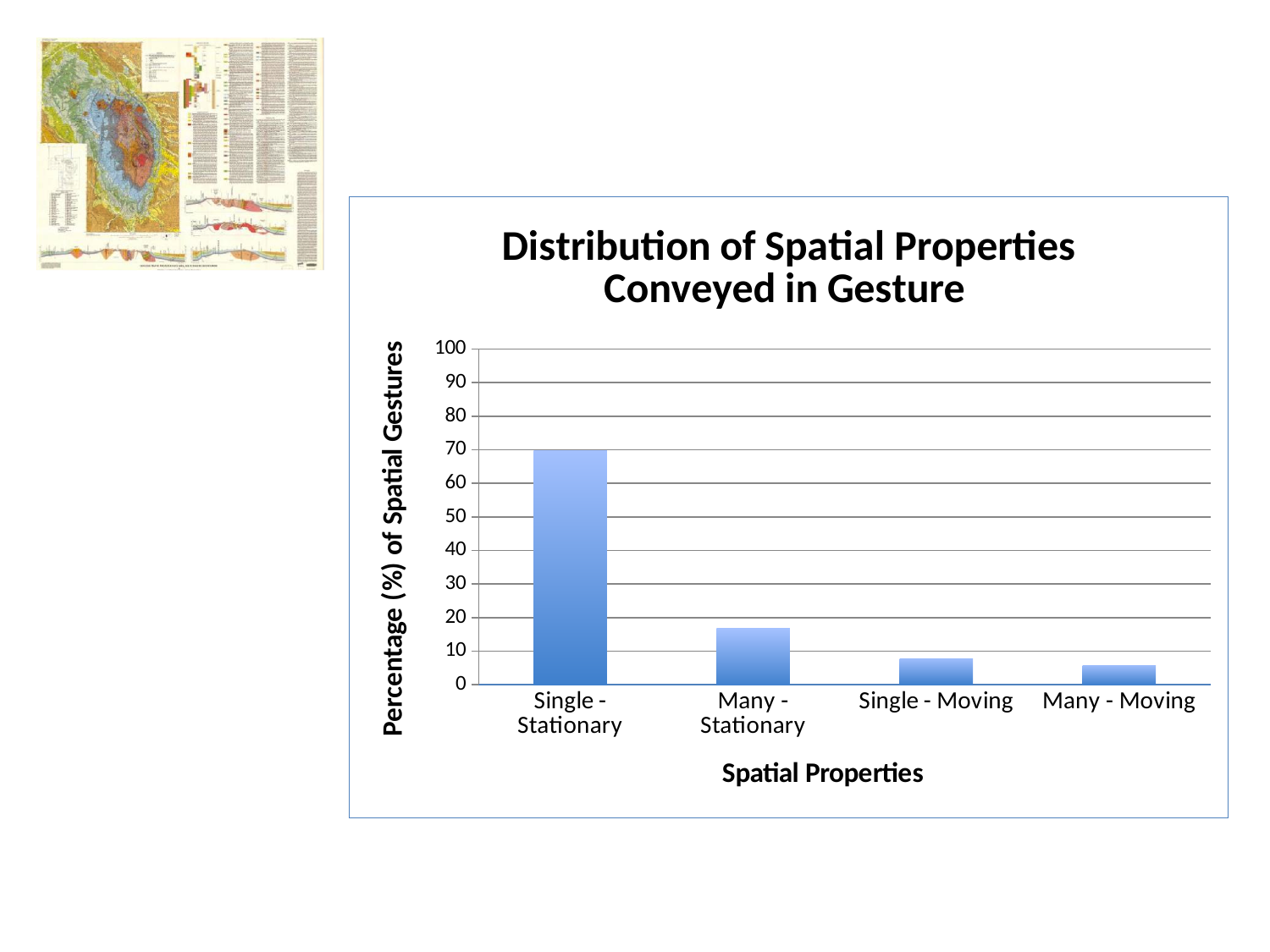
Do the values rise or fall moving from left to right along the x axis? fall How many categories are shown on the x axis of the chart? 4 Is the value for Many - Stationary greater or less than 20? less Which category has the highest percentage of spatial gestures? Single - Stationary Is the value for Many - Stationary greater or less than 10? greater Is the value for Single - Stationary greater or less than 60? greater Which is larger, the value for Many - Stationary or the value for Single - Moving? Many - Stationary What is the label of the y axis of the chart? Percentage (%) of Spatial Gestures Which category has the lowest percentage of spatial gestures? Many - Moving What kind of chart is shown on the slide? bar chart